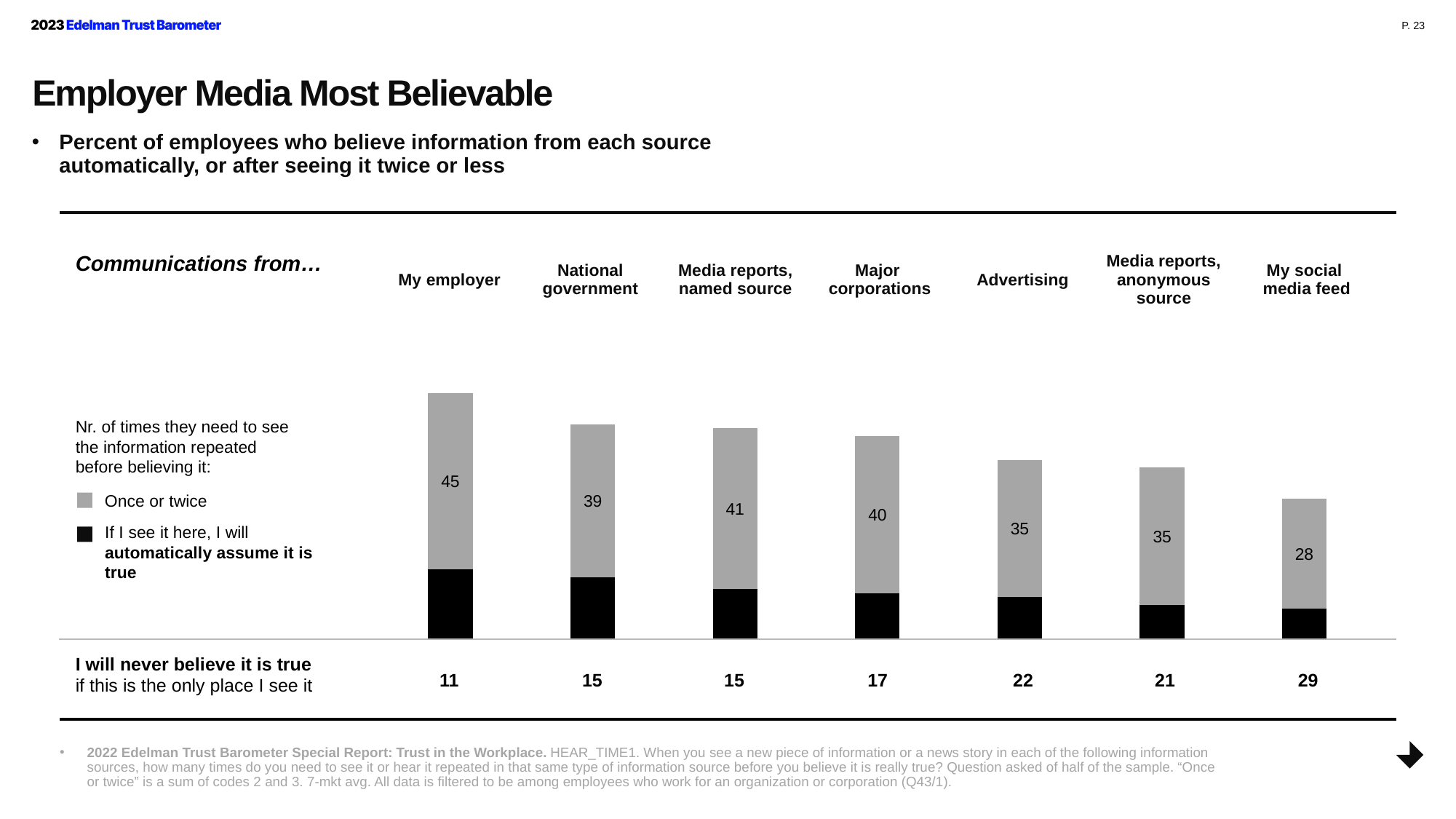
What is the "Once or twice" value for My social media feed? 28 How many series does the chart legend list? 2 What is the "Once or twice" value for My employer? 45 Which source has the highest "Once or twice" value? My employer Do the "Once or twice" values generally rise or fall from left to right across the sources? Fall What is the "I will never believe it is true" value shown for My social media feed? 29 What is the "Once or twice" value for Major corporations? 40 What kind of chart is shown on the slide? Stacked bar chart Which source has the lowest "Once or twice" value? My social media feed Which has a larger "Once or twice" value: National government or Media reports, named source? Media reports, named source How many communication sources are shown in the chart? 7 What is the difference between the "Once or twice" values for My employer and My social media feed? 17